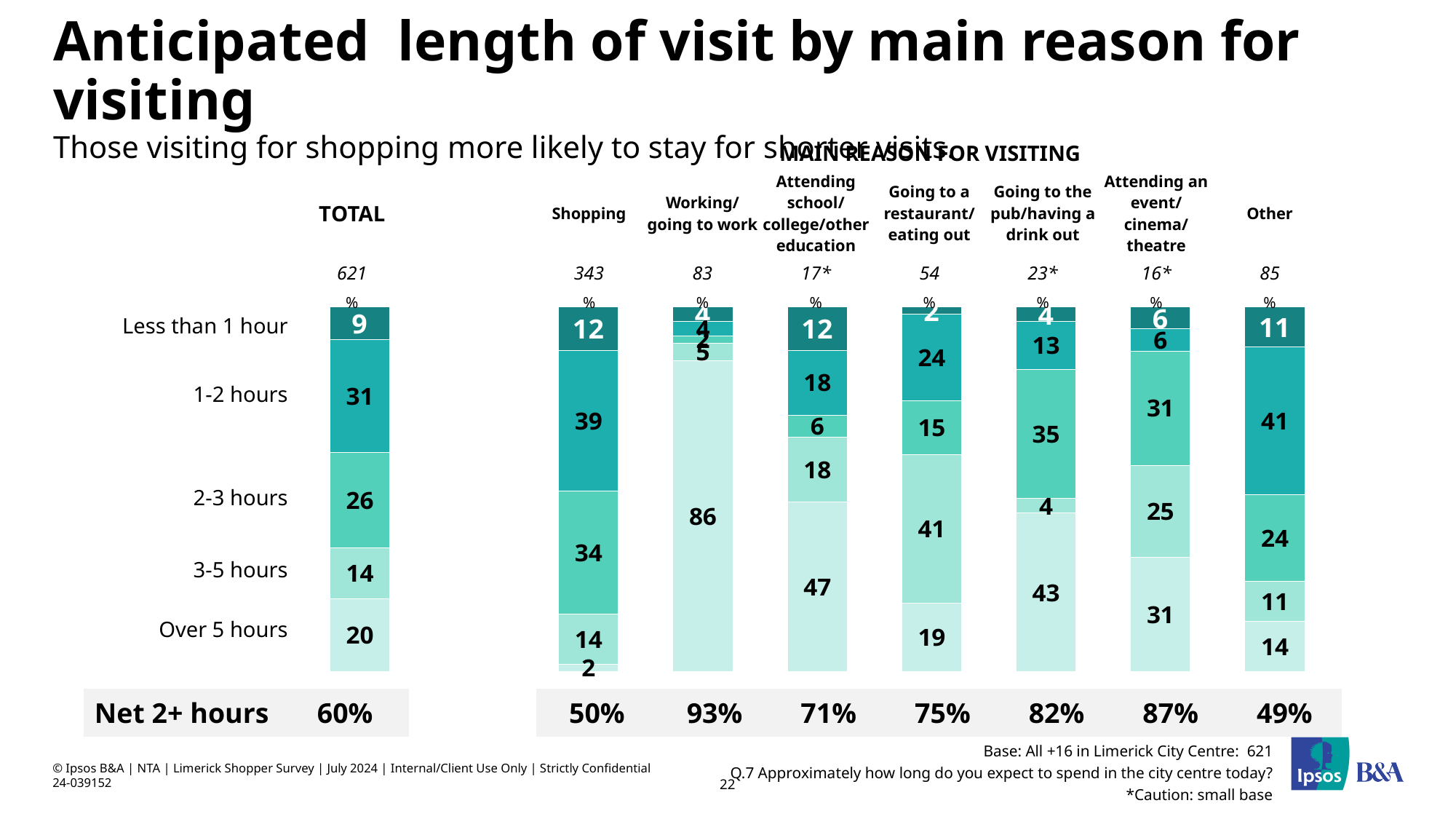
How many main reasons for visiting are shown, excluding TOTAL? 7 What is the base size shown for the Going to a restaurant/eating out group? 54 What percentage of those visiting for Shopping anticipate staying 2-3 hours? 34 Which is larger: the Over 5 hours share for Attending school/college/other education or for Going to the pub/having a drink out? Attending school/college/other education What is the Net 2+ hours figure for Going to the pub/having a drink out? 82% Which main reason for visiting has the highest Net 2+ hours figure? Working/going to work How many length-of-visit segments make up each stacked bar? 5 What type of chart is used on this slide? Stacked bar chart What is the difference between the Net 2+ hours figures for Shopping and Attending an event/cinema/theatre? 37 percentage points Which main reason for visiting has the lowest Net 2+ hours figure? Other What percentage of the TOTAL sample anticipate a visit of 1-2 hours? 31 What percentage of those Working/going to work anticipate staying Over 5 hours? 86